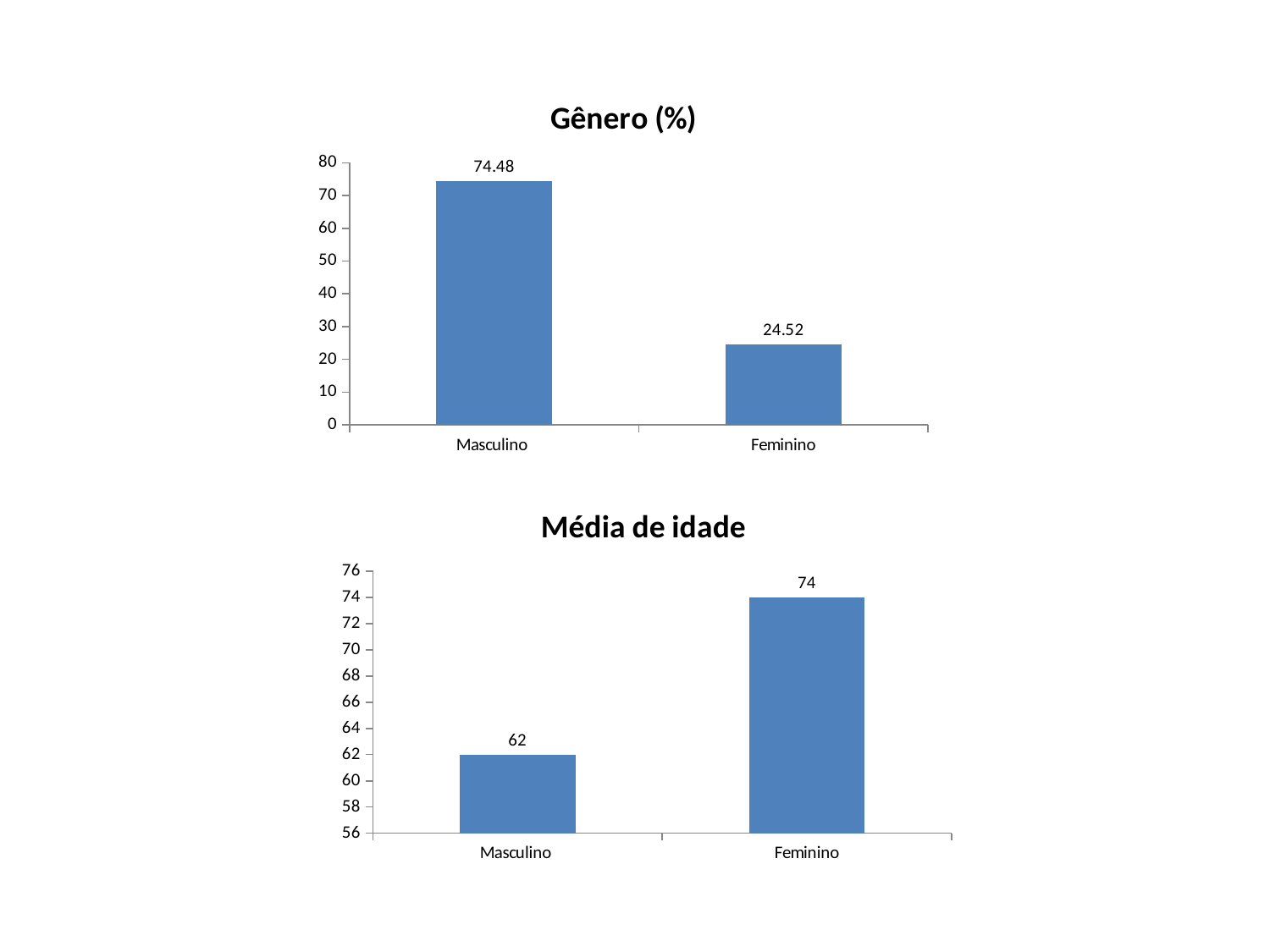
In the 'Média de idade' chart, what is the value for Masculino? 62 In the 'Gênero (%)' chart, how many categories are shown? 2 In the 'Gênero (%)' chart, which category has the highest value? Masculino In the 'Média de idade' chart, is the value for Feminino greater or less than 70? greater In the 'Média de idade' chart, which category has the lowest value? Masculino What kind of chart is the 'Gênero (%)' chart? Bar chart In the 'Média de idade' chart, what is the difference between the Feminino and Masculino values? 12 In the 'Média de idade' chart, what is the value for Feminino? 74 In the 'Gênero (%)' chart, what is the value for Feminino? 24.52 In the 'Gênero (%)' chart, what is the difference between the Masculino and Feminino values? 49.96 In the 'Gênero (%)' chart, what is the value for Masculino? 74.48 What is the title of the bottom chart on the slide? Média de idade